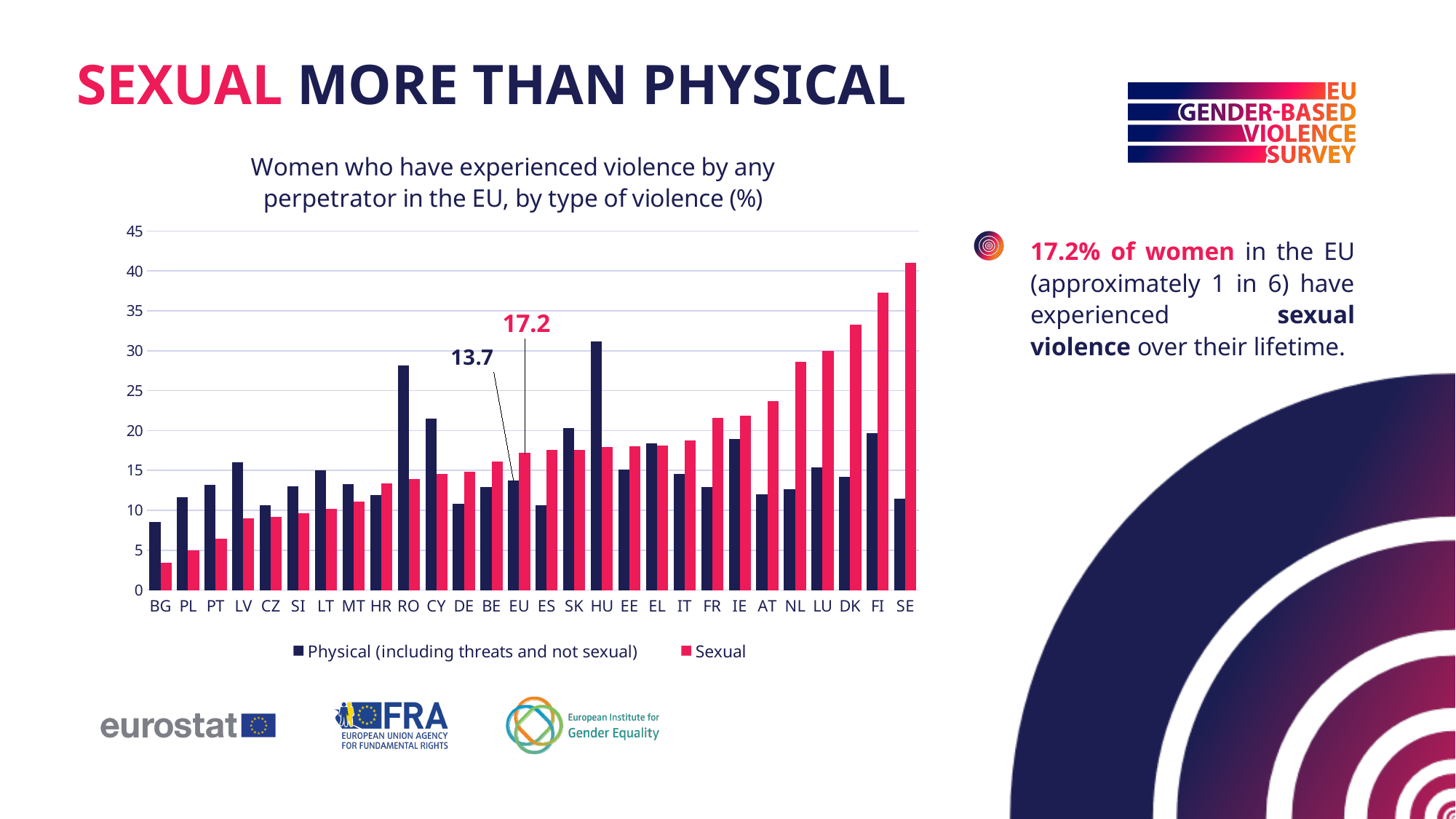
Is the Sexual value for BG greater or less than 5? less What type of chart is shown on the slide? bar chart Which country has the lowest value for Sexual violence? BG What is the difference between the EU Sexual value and the EU Physical value? 3.5 What is the value for Sexual violence for the EU? 17.2 What is the value for Physical (including threats and not sexual) violence for the EU? 13.7 Which country has the highest value for Sexual violence? SE How many countries or regions are shown on the x axis? 28 For BG, which is larger: the Physical value or the Sexual value? Physical Which country has the highest value for Physical (including threats and not sexual) violence? HU How many series does the legend list? 2 Is the Sexual value for SE greater or less than 40? greater